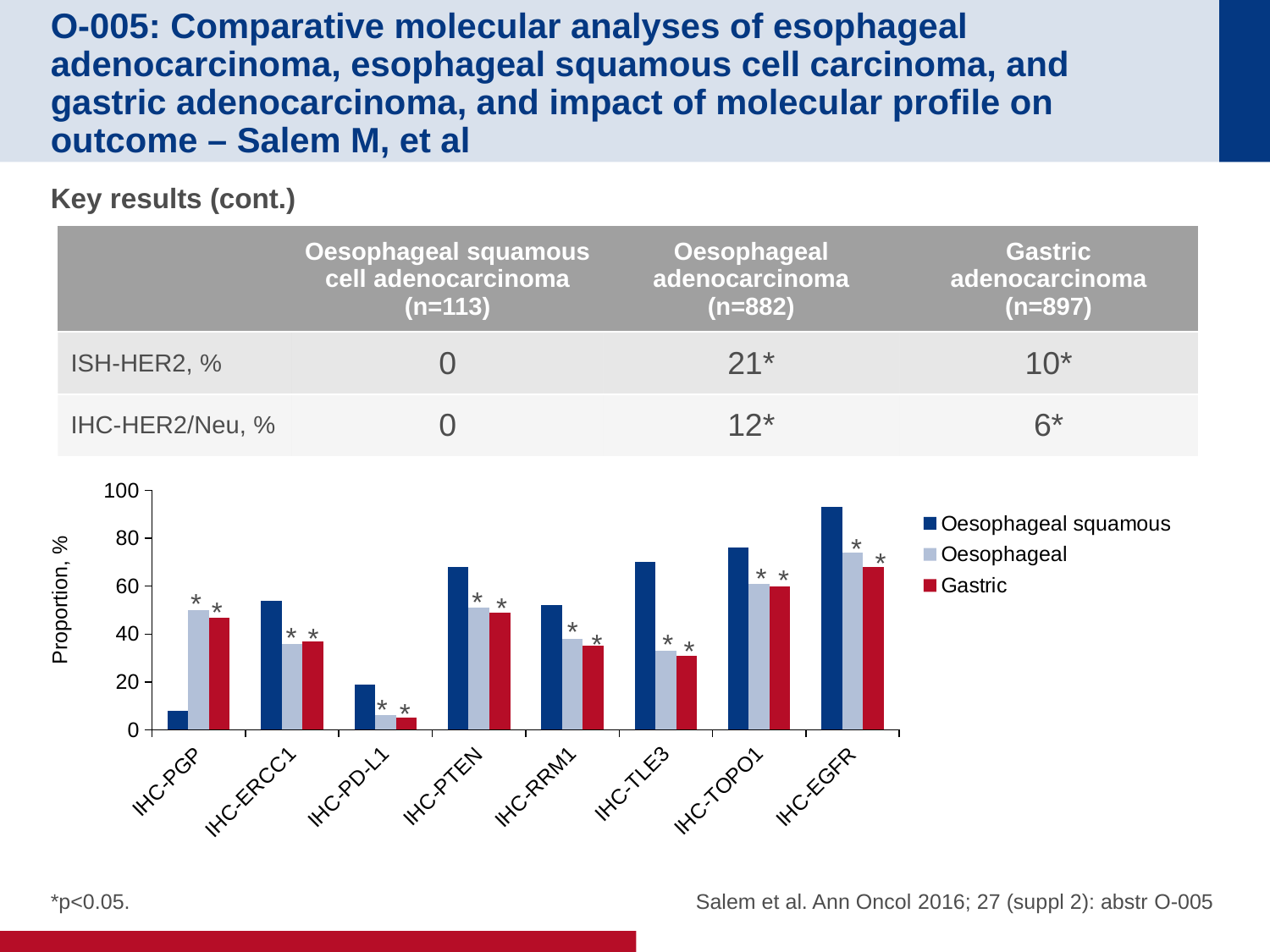
For the Gastric series, which category has the lowest proportion? IHC-PD-L1 What is the label of the y axis of the chart? Proportion, % How many series does the chart legend list? 3 For IHC-PGP, which is larger: the Oesophageal squamous value or the Oesophageal value? Oesophageal What kind of chart is shown on the slide? Bar chart Is the Gastric value for IHC-PD-L1 greater or less than 20? less How many IHC marker categories are shown on the x axis of the chart? 8 Is the Oesophageal squamous value for IHC-EGFR greater or less than 80? greater Is the Oesophageal value for IHC-TOPO1 greater or less than 40? greater For the Oesophageal squamous series, which category has the lowest proportion? IHC-PGP For the Oesophageal squamous series, which category has the highest proportion? IHC-EGFR For IHC-TLE3, which is larger: the Oesophageal squamous value or the Gastric value? Oesophageal squamous